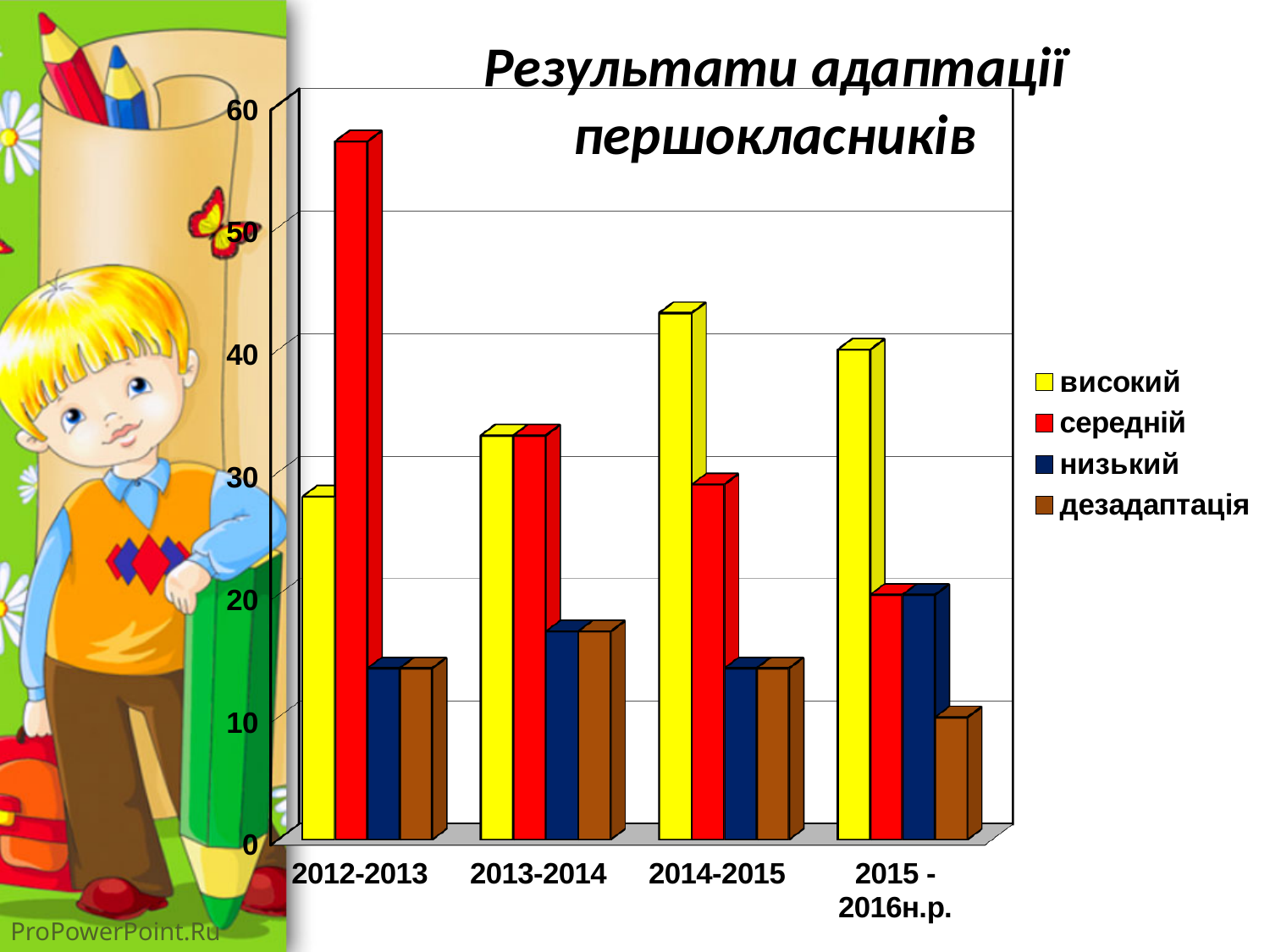
How many series does the legend list? 4 How many school-year categories are shown on the x axis? 4 Is the value for 'високий' in 2014-2015 greater or less than 40? greater What is the title of the chart? Результати адаптації першокласників Is the value for 'низький' in 2012-2013 greater or less than 20? less Which colour represents the series 'дезадаптація' in the legend? brown Which series has the lowest bar in 2015-2016н.р.? дезадаптація What kind of chart is shown on the slide? bar chart Is the value for 'середній' in 2012-2013 greater or less than 50? greater Which series has the highest bar in 2014-2015? високий Does the value for 'середній' rise or fall from 2012-2013 to 2015-2016н.р.? fall Which series has the highest bar in 2012-2013? середній